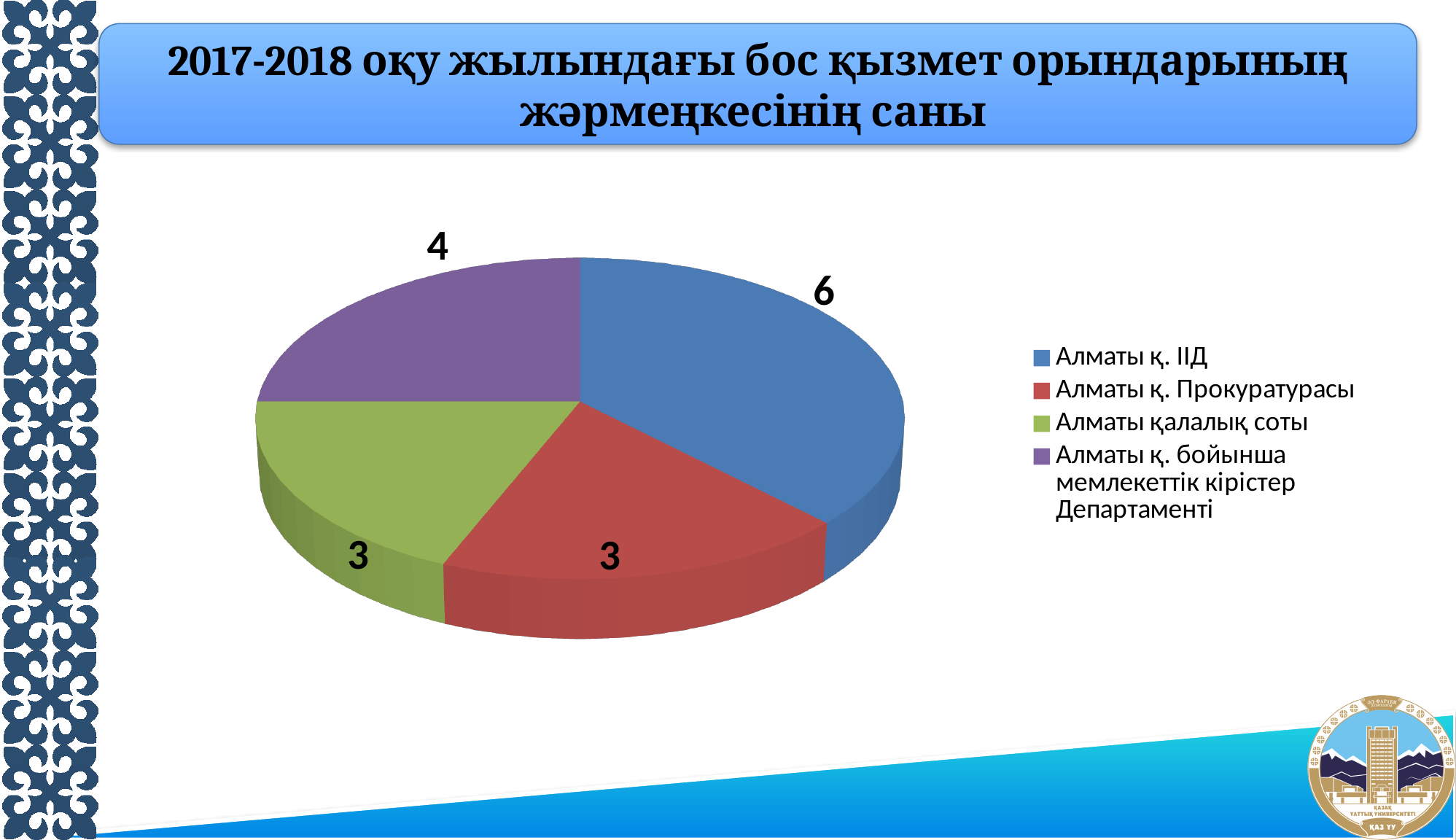
What is the value for Алматы қ. Прокуратурасы? 3 What colour is the slice for Алматы қалалық соты? Green Which category has the largest slice of the pie? Алматы қ. ІІД What is the difference between the values for Алматы қ. бойынша мемлекеттік кірістер Департаменті and Алматы қ. Прокуратурасы? 1 What is the difference between the values for Алматы қ. ІІД and Алматы қалалық соты? 3 What is the value for Алматы қ. бойынша мемлекеттік кірістер Департаменті? 4 What is the total of all the values shown in the pie chart? 16 How many categories does the pie chart have? 4 Which is larger: the value for Алматы қ. ІІД or the value for Алматы қ. бойынша мемлекеттік кірістер Департаменті? Алматы қ. ІІД What share of the pie does Алматы қ. бойынша мемлекеттік кірістер Департаменті represent? 25% What type of chart is shown on the slide? Pie chart What is the value for Алматы қ. ІІД? 6